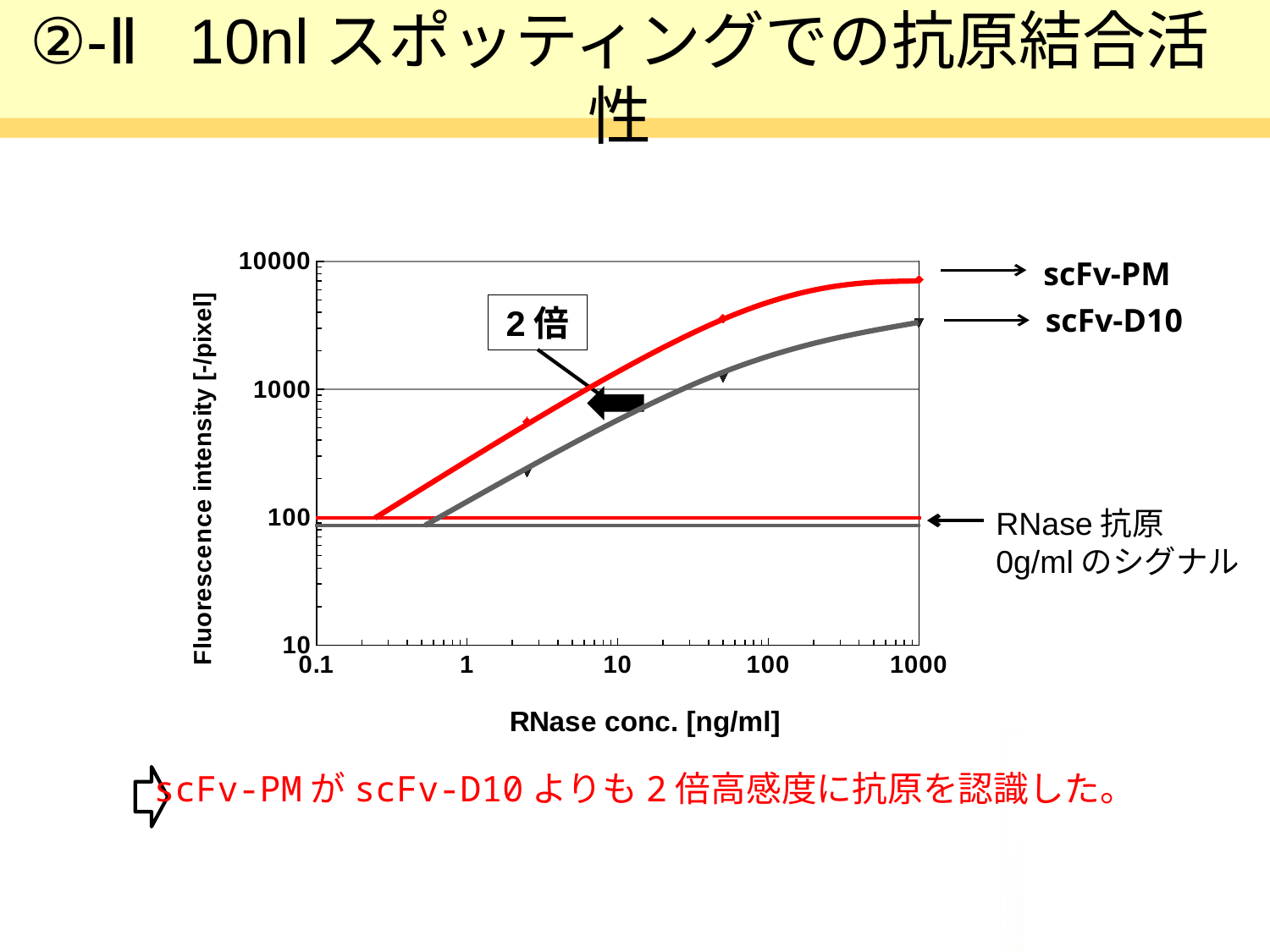
What are the names of the two series plotted in the chart? scFv-PM and scFv-D10 Which series has the lower fluorescence intensity at 10 ng/ml, scFv-PM or scFv-D10? scFv-D10 How many series are plotted in the chart (labelled at the right of the curves)? 2 Is the fluorescence intensity of scFv-PM at 1 ng/ml greater or less than 1000? less Is the fluorescence intensity of scFv-D10 at 100 ng/ml greater or less than 1000? greater Is the fluorescence intensity of scFv-D10 at 1 ng/ml greater or less than 1000? less Which series has the higher fluorescence intensity at 1000 ng/ml, scFv-PM or scFv-D10? scFv-PM What is the label of the x axis of the chart? RNase conc. [ng/ml] Does the fluorescence intensity of scFv-PM rise or fall as RNase concentration increases along the x axis? rise What kind of chart is shown on the slide? line chart